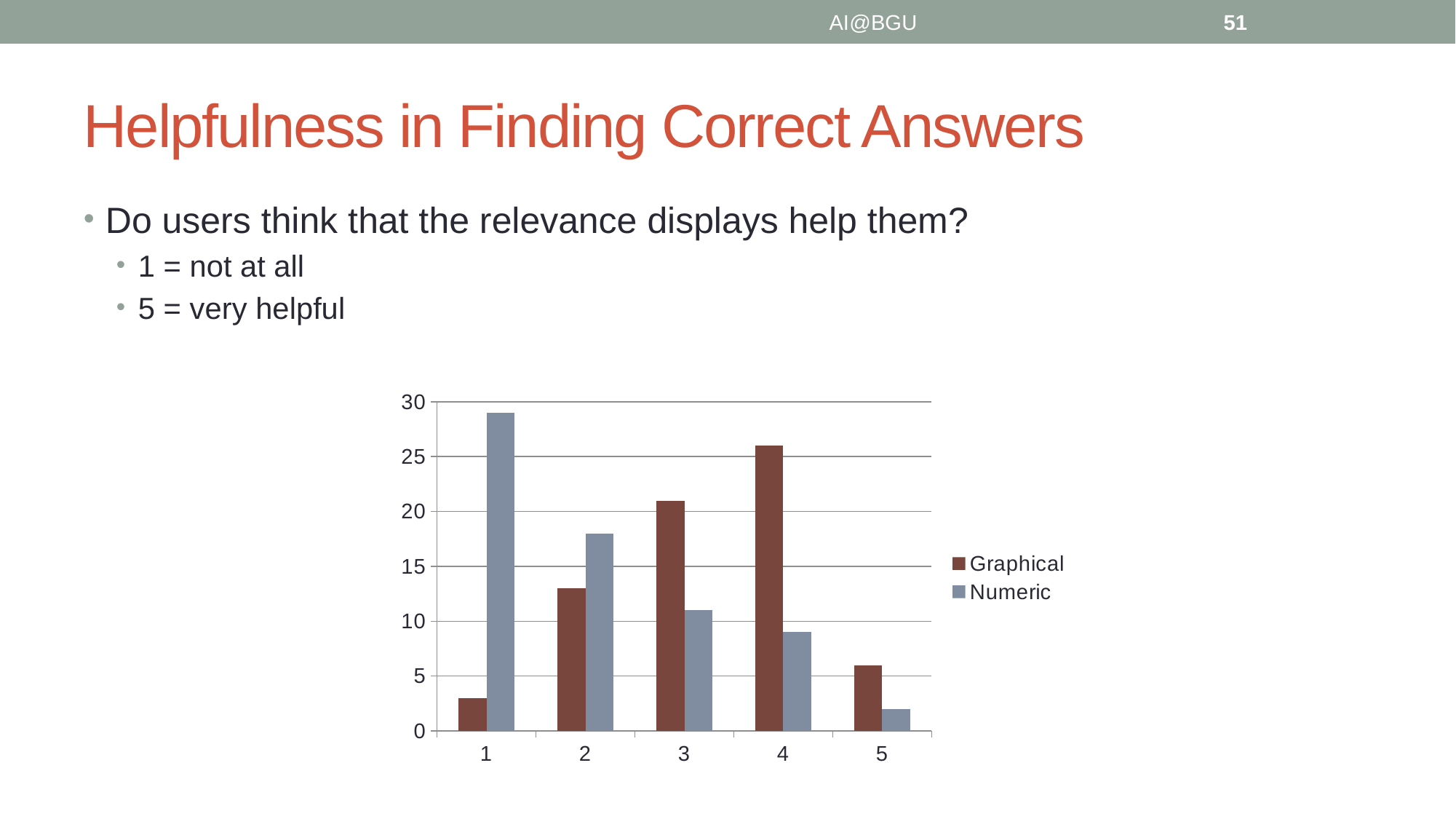
Is the Graphical value for category 1 greater or less than 5? less How many categories are shown on the x axis of the chart? 5 Which category has the highest Graphical value? 4 Which category has the lowest Numeric value? 5 Do the Numeric values rise or fall from category 1 to category 5? fall Which category has the highest Numeric value? 1 For category 3, which series has the larger value, Graphical or Numeric? Graphical What kind of chart is shown on the slide? bar chart How many series does the chart legend list? 2 Is the Numeric value for category 1 greater or less than 25? greater Which category has the lowest Graphical value? 1